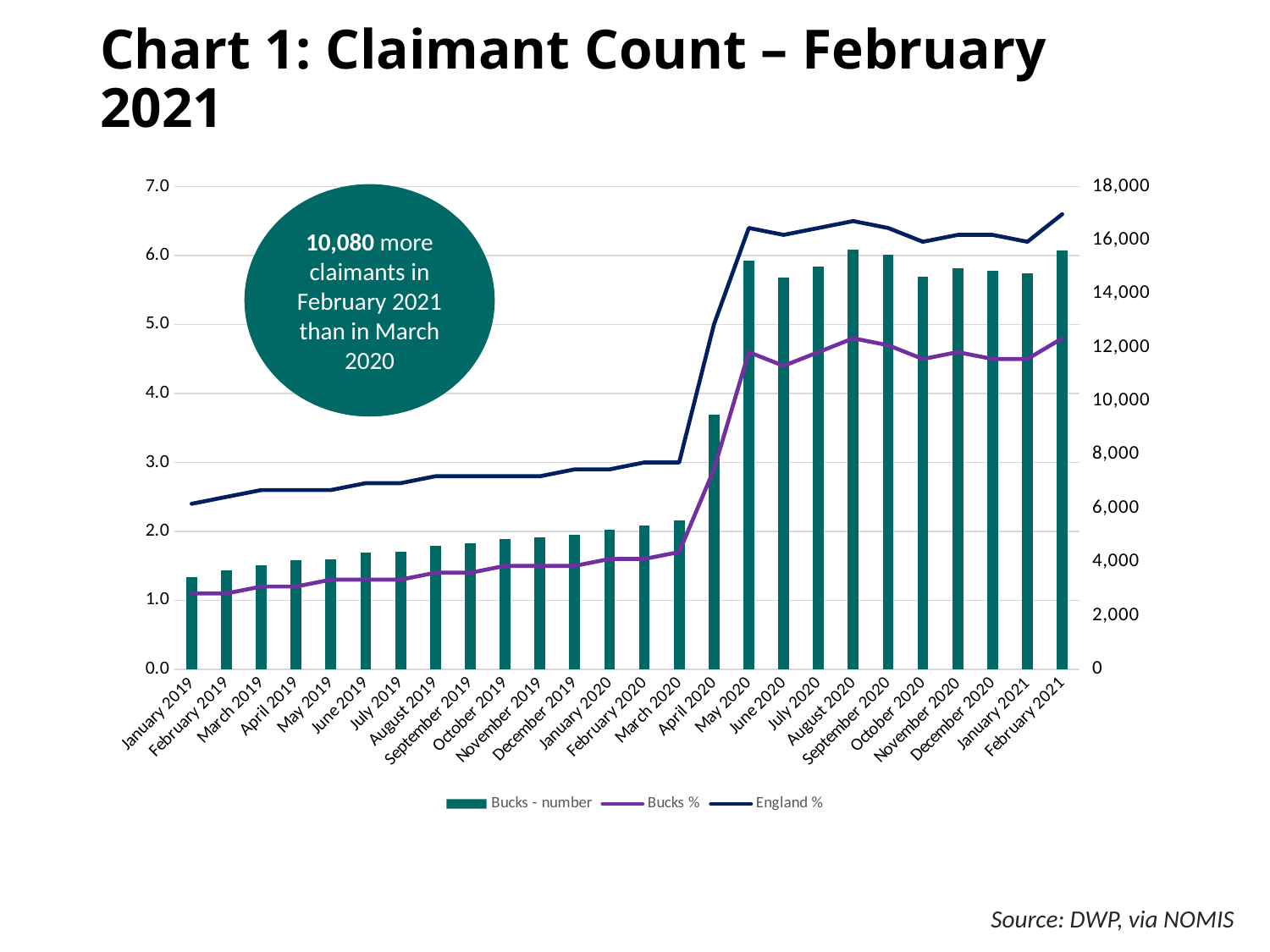
Is the Bucks % value in May 2020 greater or less than 4.0? greater How many series does the legend list? 3 Is the value for Bucks - number in February 2021 greater or less than 14,000? greater Is the England % value in February 2021 greater or less than 6.0? greater What is the title of the chart? Chart 1: Claimant Count – February 2021 Which is larger, the Bucks - number value in April 2020 or in May 2020? May 2020 What kind of chart is this? Combined bar and line chart In February 2021, which line is higher, Bucks % or England %? England % Which month has the lowest value for Bucks - number? January 2019 According to the callout on the chart, how many more claimants were there in February 2021 than in March 2020? 10,080 How many months are shown on the x axis? 26